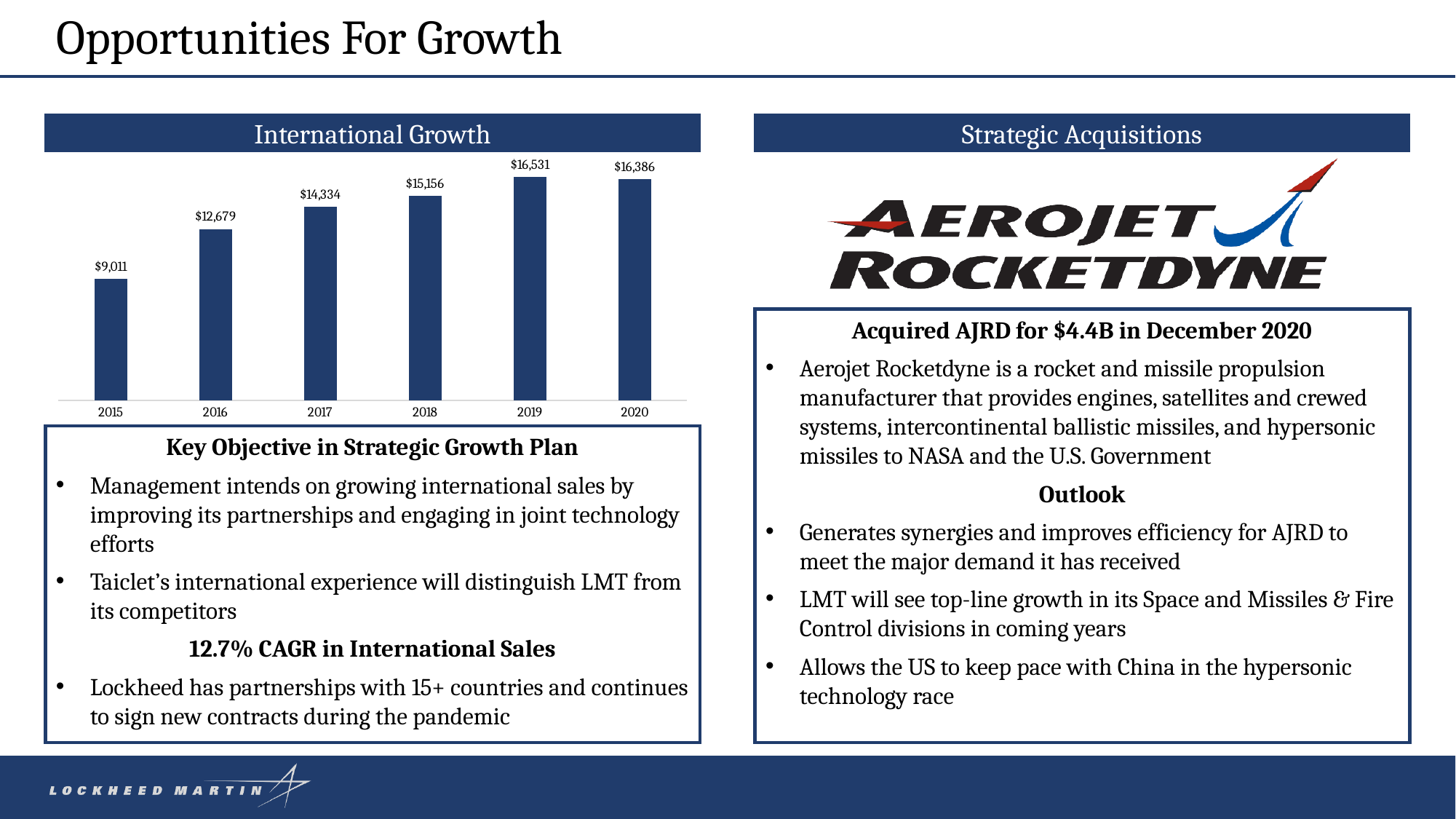
Which year has the highest value in the International Growth chart? 2019 What is the value for 2015 in the International Growth chart? $9,011 What is the value for 2020 in the International Growth chart? $16,386 What is the value for 2018 in the International Growth chart? $15,156 What is the difference between the 2019 and 2020 values in the International Growth chart? $145 In the International Growth chart, is the value for 2017 larger or smaller than the value for 2018? smaller In the International Growth chart, do the values generally rise or fall from 2015 to 2019? rise What is the difference between the 2016 and 2015 values in the International Growth chart? $3,668 How many years are shown in the International Growth chart? 6 Which year has the lowest value in the International Growth chart? 2015 What is the title of the chart on the left side of the slide? International Growth What kind of chart is the International Growth chart? bar chart